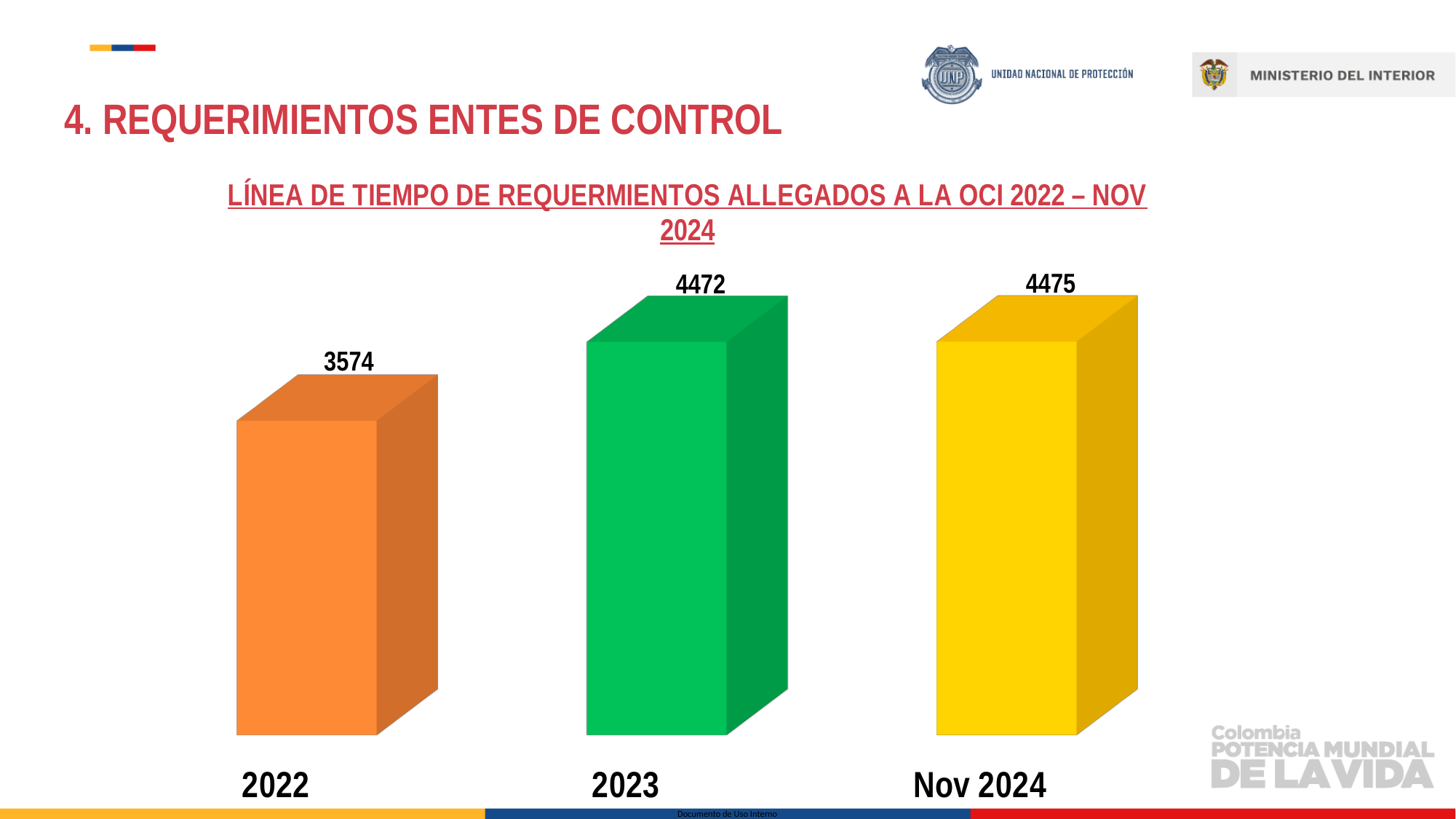
How many categories are shown on the chart? 3 What kind of chart is shown on the slide? bar chart Which category has the lowest value? 2022 What is the total of the three values shown on the chart? 12521 What is the value for Nov 2024? 4475 What is the difference between the values for Nov 2024 and 2023? 3 What is the difference between the values for 2023 and 2022? 898 What is the value for 2023? 4472 What is the value for 2022? 3574 What colour is the bar for 2023? green Do the values rise or fall from 2022 to Nov 2024? rise Which is larger, the value for 2022 or the value for 2023? 2023